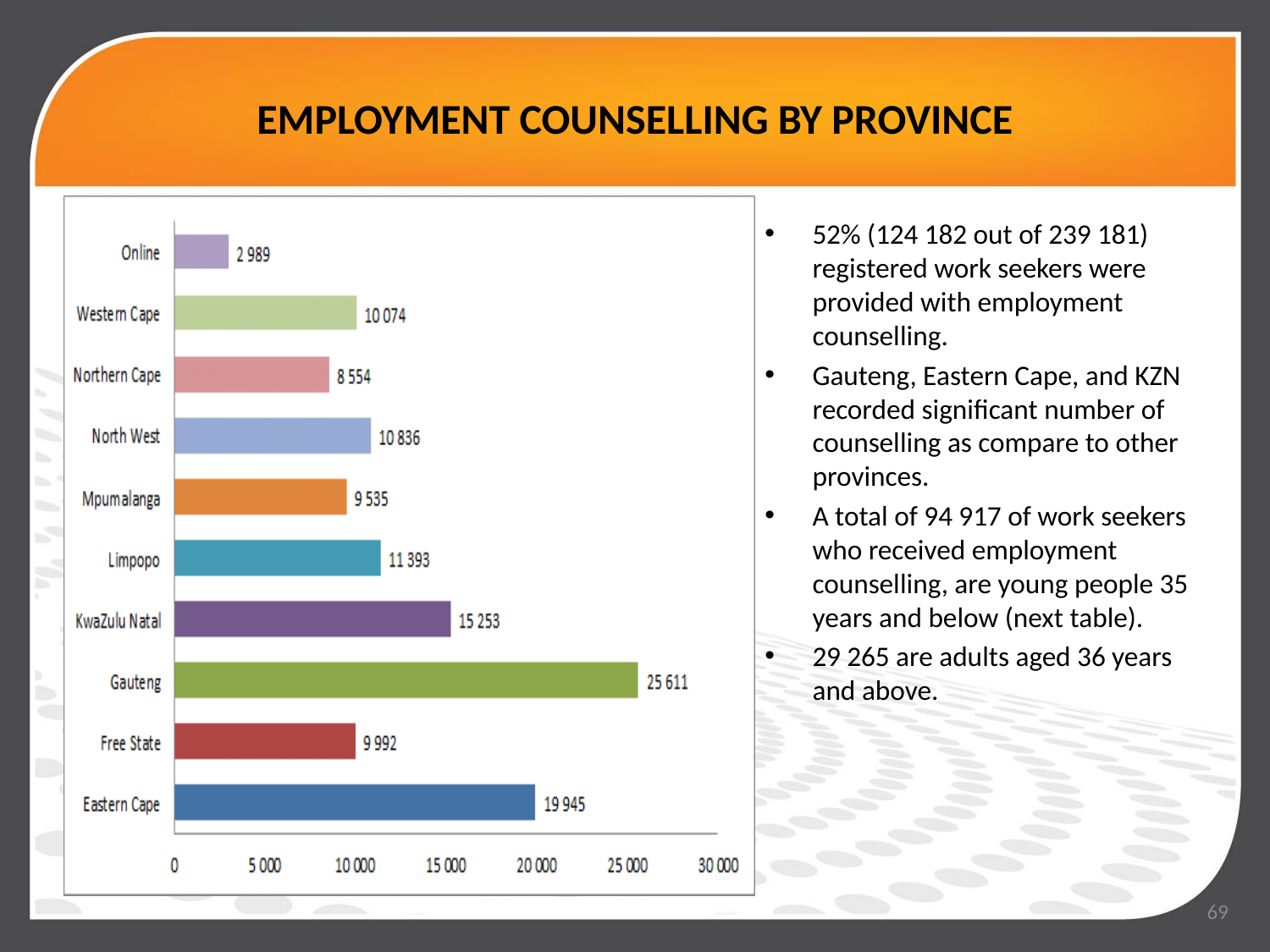
What kind of chart is shown on the slide? bar chart Which category has the highest value? Gauteng What value is shown for Eastern Cape? 19 945 Which is larger, the value for KwaZulu Natal or the value for Limpopo? KwaZulu Natal What value is shown for Online? 2 989 What value is shown for Limpopo? 11 393 What is the difference between the values for Gauteng and Eastern Cape? 5 666 Which category has the lowest value? Online What is the title of the slide containing the chart? EMPLOYMENT COUNSELLING BY PROVINCE What value is shown for Gauteng? 25 611 Is the value for Northern Cape greater or less than 10 000? less How many categories are shown in the chart? 10